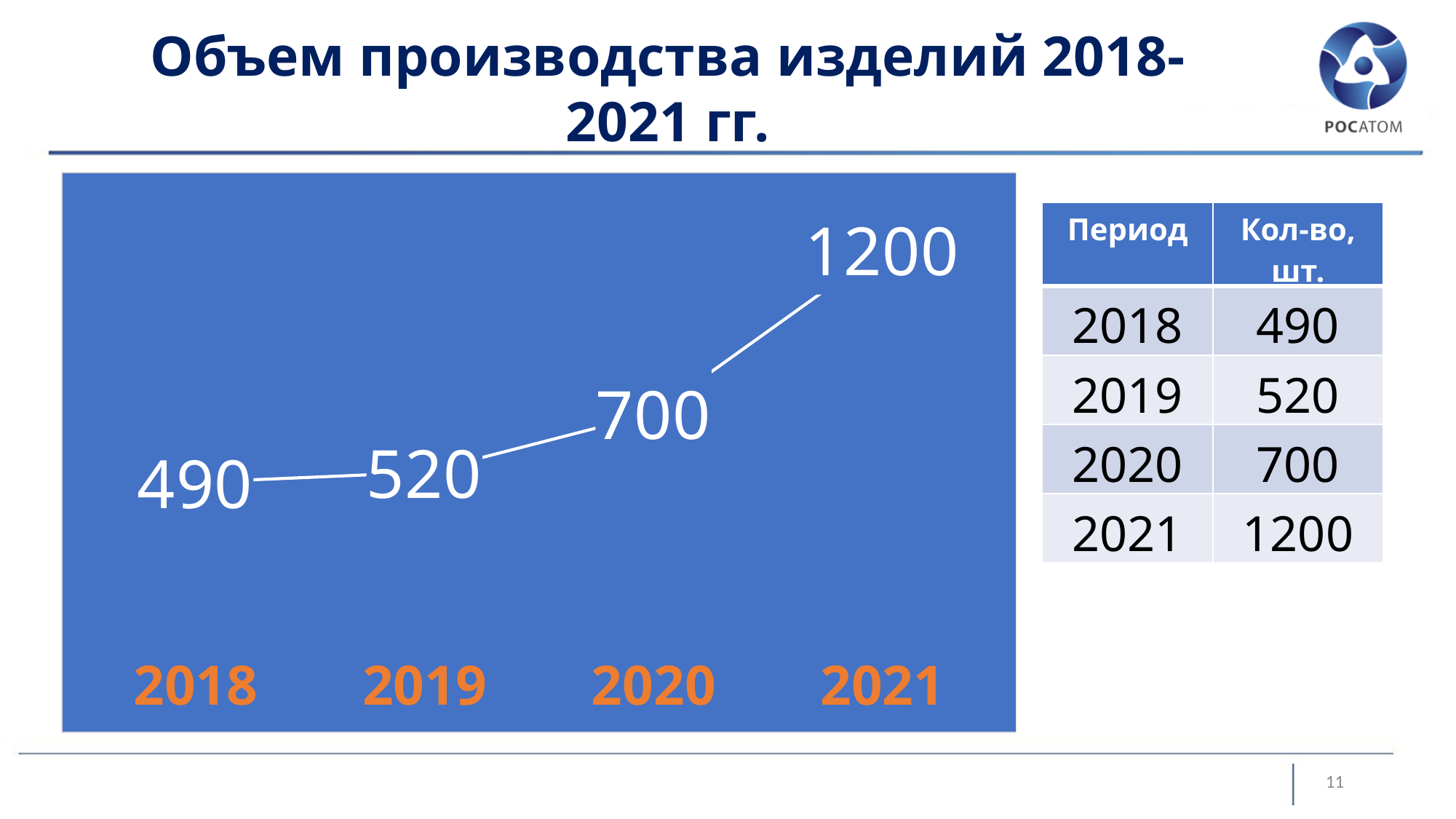
What kind of chart is shown? line chart What is the value for 2020? 700 Do the values rise or fall from 2018 to 2021? rise What is the value for 2018? 490 What is the value for 2021? 1200 Which is larger, the value for 2020 or the value for 2019? 2020 What is the difference between the values for 2019 and 2018? 30 Which year has the highest value? 2021 What is the value for 2019? 520 Which year has the lowest value? 2018 How many years are plotted on the chart? 4 What is the difference between the values for 2021 and 2020? 500